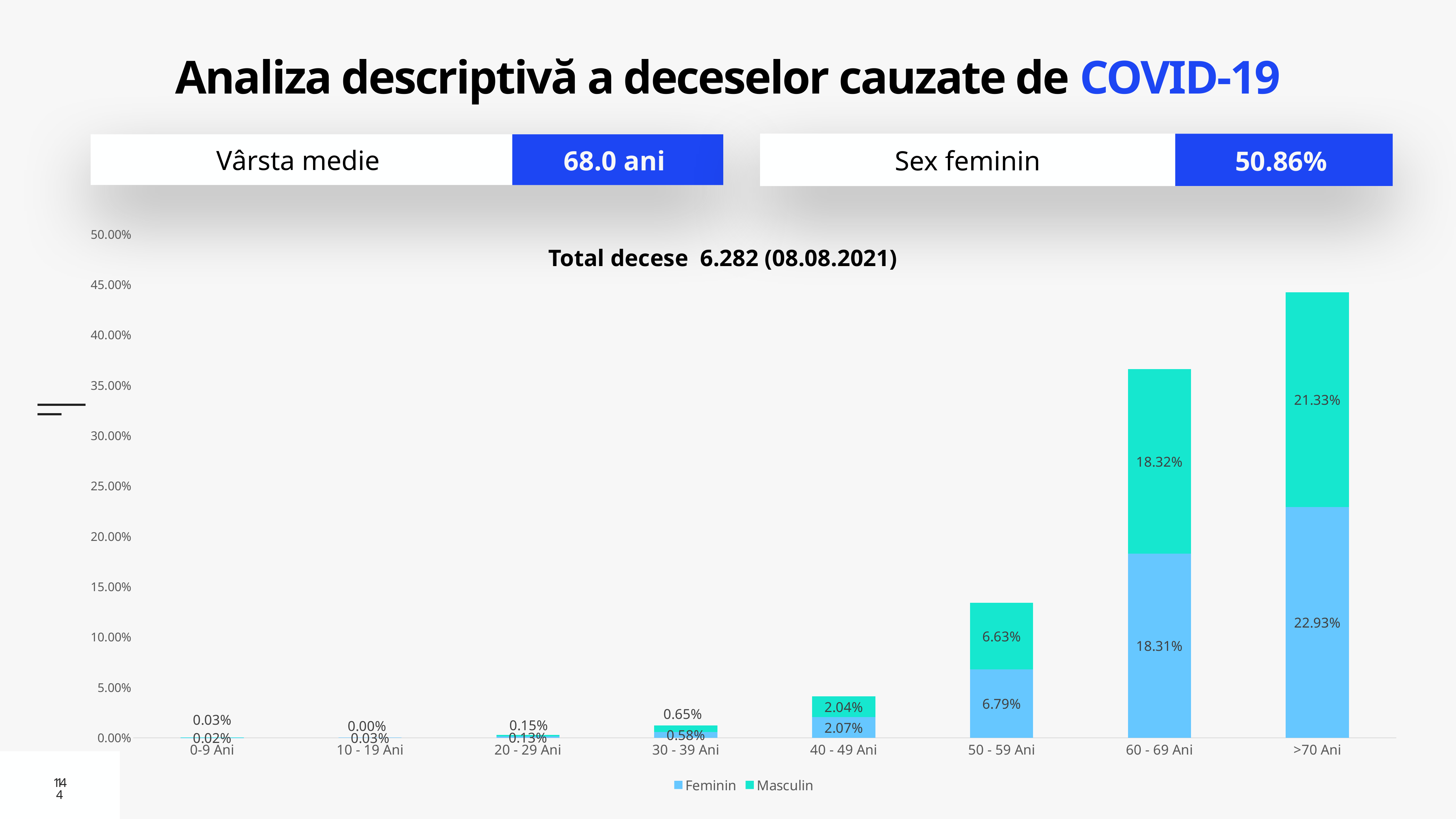
What is the total of the stacked bar for the 50 - 59 Ani age group? 13.42% Which is larger: the Masculin value for 50 - 59 Ani or the Masculin value for 40 - 49 Ani? 50 - 59 Ani Which age group has the lowest Masculin value? 10 - 19 Ani What kind of chart is shown on the slide? Stacked bar chart What is the difference between the Feminin and Masculin values for the >70 Ani age group? 1.60% What is the Masculin value for the 60 - 69 Ani age group? 18.32% How many age groups are shown on the x axis? 8 What is the Feminin value for the >70 Ani age group? 22.93% What is the Masculin value for the 40 - 49 Ani age group? 2.04% Which age group has the highest Masculin value? >70 Ani What is the Feminin value for the 50 - 59 Ani age group? 6.79% How many series does the legend list? 2